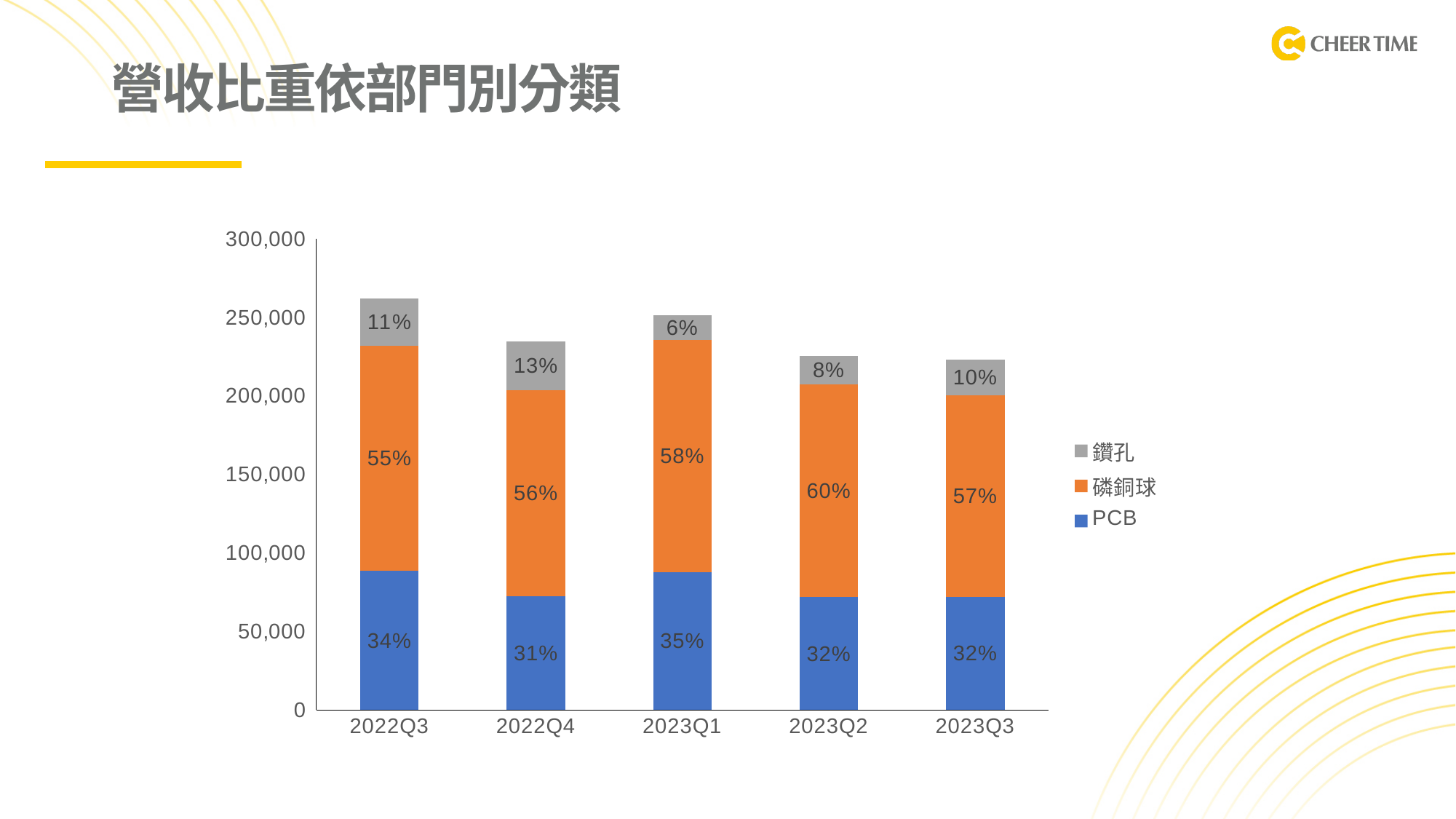
What kind of chart is shown on the slide? Stacked bar chart How many quarters are shown on the x axis? 5 What percentage share does PCB have in 2022Q3? 34% Which is larger in 2022Q4: the PCB share or the 鑽孔 share? PCB What percentage share does 磷銅球 have in 2023Q2? 60% Is the total bar height for 2022Q3 greater or less than 250,000? greater What percentage share does 鑽孔 have in 2022Q4? 13% What is the difference between the 磷銅球 share and the PCB share in 2023Q3? 25% In which quarter is the 磷銅球 share the highest? 2023Q2 In which quarter is the 鑽孔 share the lowest? 2023Q1 Is the total bar height for 2023Q2 greater or less than 250,000? less How many series does the legend list? 3